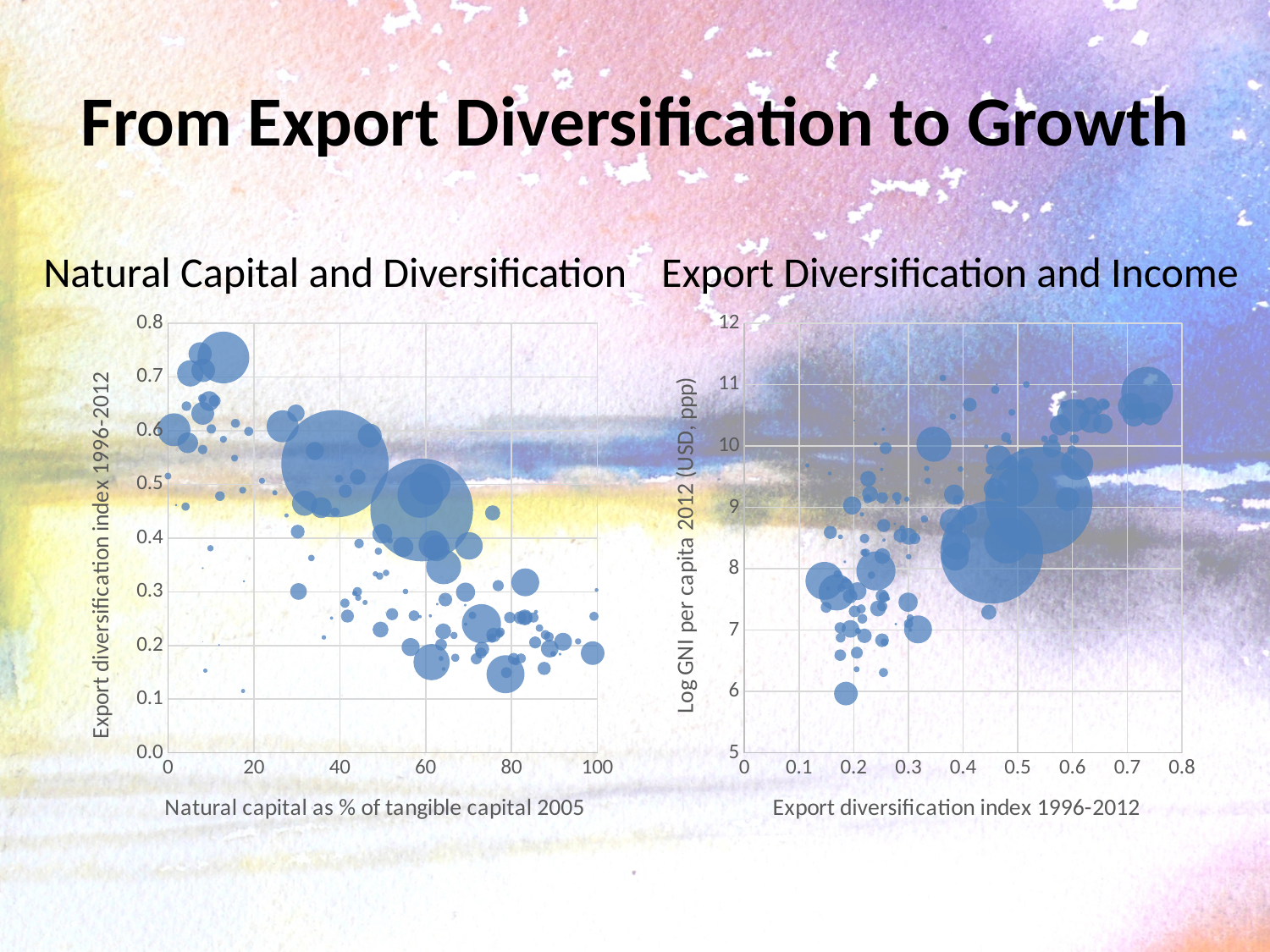
What is the x-axis title of the 'Natural Capital and Diversification' chart? Natural capital as % of tangible capital 2005 How many charts are shown on the slide? 2 What kind of chart is the 'Export Diversification and Income' chart on the right? Bubble chart What kind of chart is the 'Natural Capital and Diversification' chart on the left? Bubble chart What is the y-axis title of the 'Export Diversification and Income' chart? Log GNI per capita 2012 (USD, ppp) In the 'Export Diversification and Income' chart, does log GNI per capita generally rise or fall as the export diversification index increases? Rise In the 'Natural Capital and Diversification' chart, do the export diversification index values generally rise or fall as natural capital as % of tangible capital increases? Fall